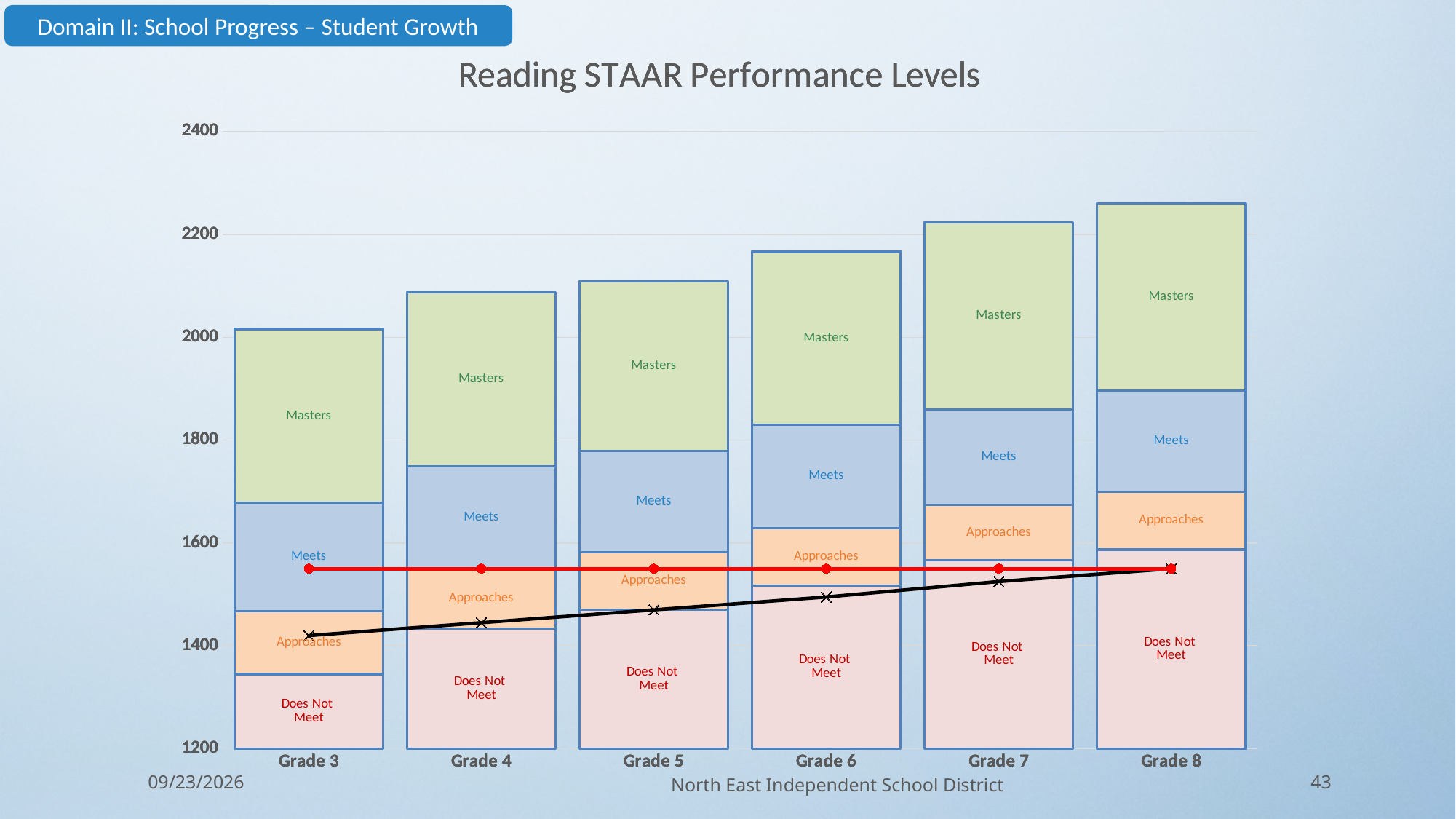
Which bar reaches higher, Grade 7 or Grade 4? Grade 7 How many grade categories are shown on the x axis? 6 Does the black line rise or fall from Grade 3 to Grade 8? rise Do the bar tops rise or fall from Grade 3 to Grade 8? rise Is the top of the Grade 8 bar greater or less than 2200? greater Which grade has the shortest bar? Grade 3 What kind of chart is shown on the slide? combination stacked bar and line chart How many performance level segments make up each bar? 4 Which performance level is the top segment of each bar? Masters What is the title of the chart? Reading STAAR Performance Levels Is the top of the Grade 4 bar greater or less than 2200? less Which grade has the tallest bar? Grade 8